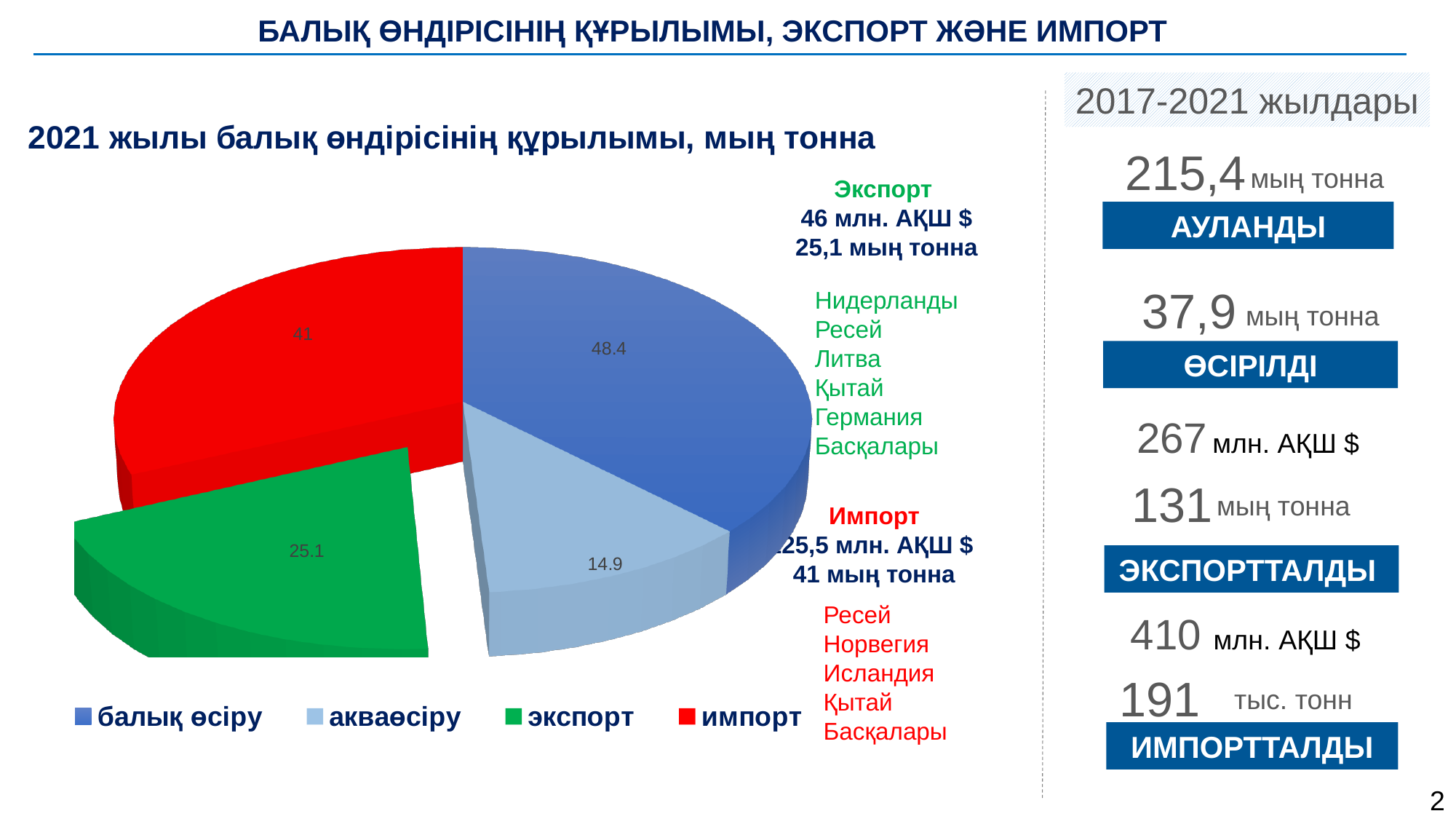
What type of chart is shown on the slide? Pie chart What is the value for балық өсіру in the pie chart? 48.4 Which category has the smallest slice in the pie chart? аквaөсіру What is the value for аквaөсіру in the pie chart? 14.9 What is the difference between the values for импорт and экспорт? 15.9 Which is larger, the value for импорт or the value for экспорт? импорт What is the title of the pie chart? 2021 жылы балық өндірісінің құрылымы, мың тонна Which category has the largest slice in the pie chart? балық өсіру What is the value for экспорт in the pie chart? 25.1 How many slices does the pie chart have? 4 What is the value for импорт in the pie chart? 41 What is the difference between the values for балық өсіру and аквaөсіру? 33.5